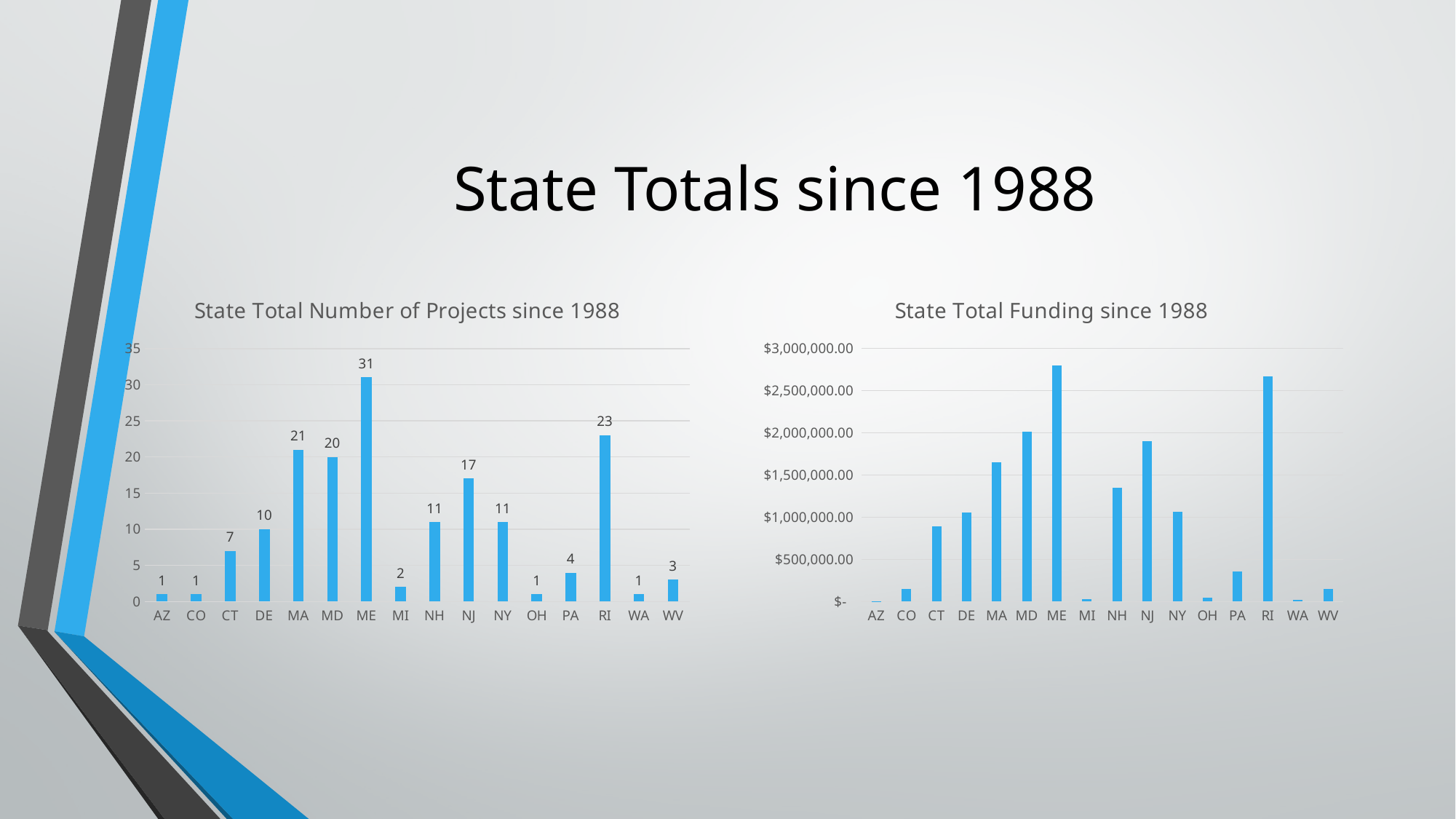
In the 'State Total Number of Projects since 1988' chart, what is the difference between the values for ME and RI? 8 In the 'State Total Number of Projects since 1988' chart, what is the difference between the values for MA and MD? 1 In the 'State Total Funding since 1988' chart, which is larger, the value for NJ or the value for NY? NJ What kind of chart is the 'State Total Funding since 1988' chart? bar chart In the 'State Total Funding since 1988' chart, which state has the highest funding? ME In the 'State Total Number of Projects since 1988' chart, which state has the highest number of projects? ME In the 'State Total Number of Projects since 1988' chart, how many projects does ME have? 31 In the 'State Total Number of Projects since 1988' chart, which is larger, the value for NJ or the value for NY? NJ In the 'State Total Funding since 1988' chart, is the value for NH greater or less than $1,500,000.00? less In the 'State Total Number of Projects since 1988' chart, how many projects does RI have? 23 In the 'State Total Number of Projects since 1988' chart, how many states are shown on the x axis? 16